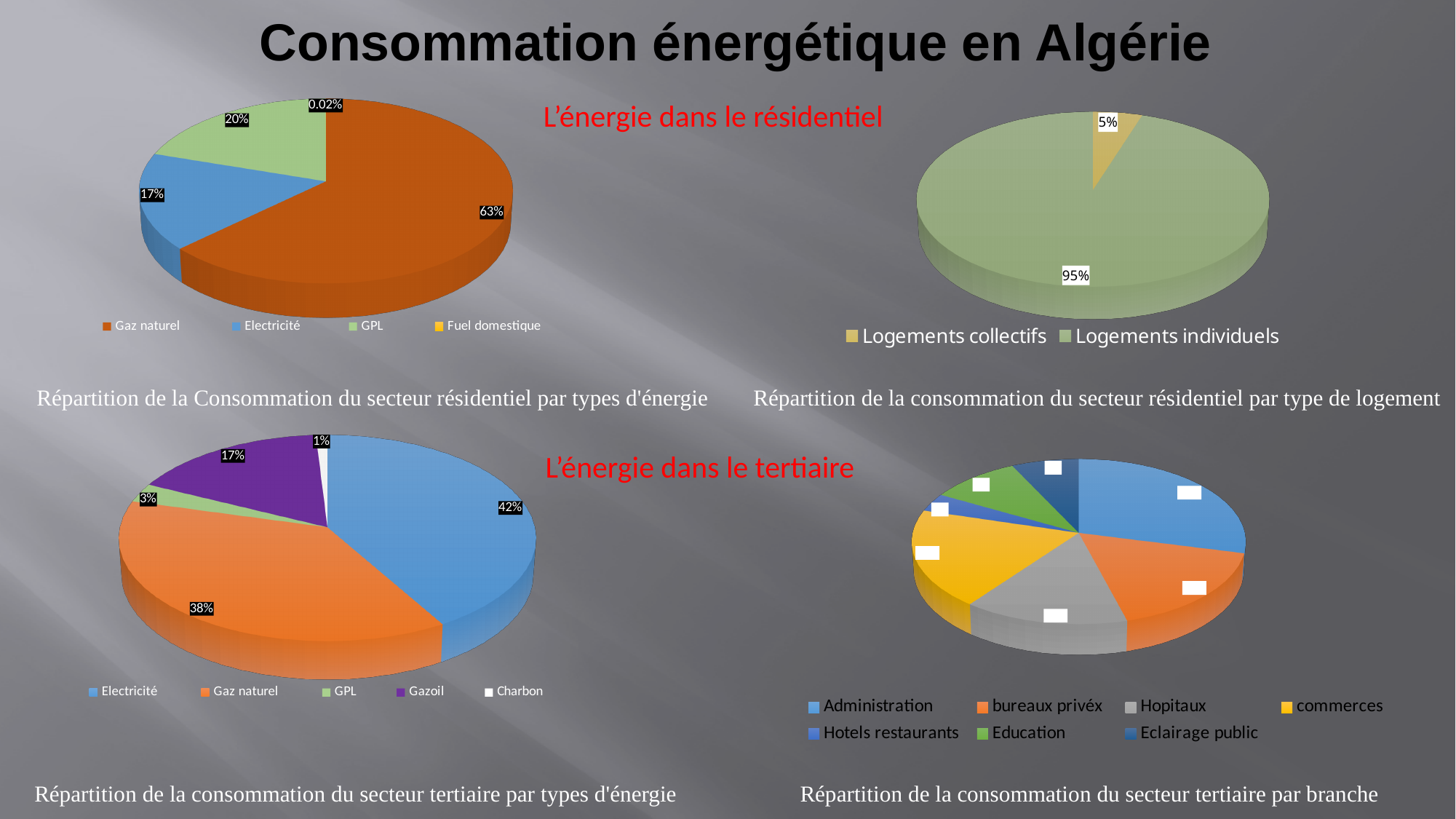
In the chart 'Répartition de la consommation du secteur tertiaire par types d'énergie', what share does Gazoil have? 17% In the chart 'Répartition de la Consommation du secteur résidentiel par types d'énergie', what share does GPL have? 20% In the chart 'Répartition de la Consommation du secteur résidentiel par types d'énergie', which energy type has the smallest share? Fuel domestique In the chart 'Répartition de la consommation du secteur tertiaire par types d'énergie', what is the difference between the shares of Electricité and Gaz naturel? 4% In the chart 'Répartition de la consommation du secteur tertiaire par types d'énergie', which energy type has the largest share? Electricité In the chart 'Répartition de la consommation du secteur tertiaire par types d'énergie', which is larger, Gaz naturel or Electricité? Electricité In the chart 'Répartition de la consommation du secteur résidentiel par type de logement', what share do Logements individuels have? 95% What kind of chart is 'Répartition de la consommation du secteur tertiaire par branche'? Pie chart In the chart 'Répartition de la Consommation du secteur résidentiel par types d'énergie', what share does Gaz naturel have? 63% In the chart 'Répartition de la consommation du secteur résidentiel par type de logement', how many categories are shown? 2 In the chart 'Répartition de la consommation du secteur tertiaire par branche', how many branches does the legend list? 7 In the chart 'Répartition de la Consommation du secteur résidentiel par types d'énergie', what is the difference between the shares of GPL and Electricité? 3%